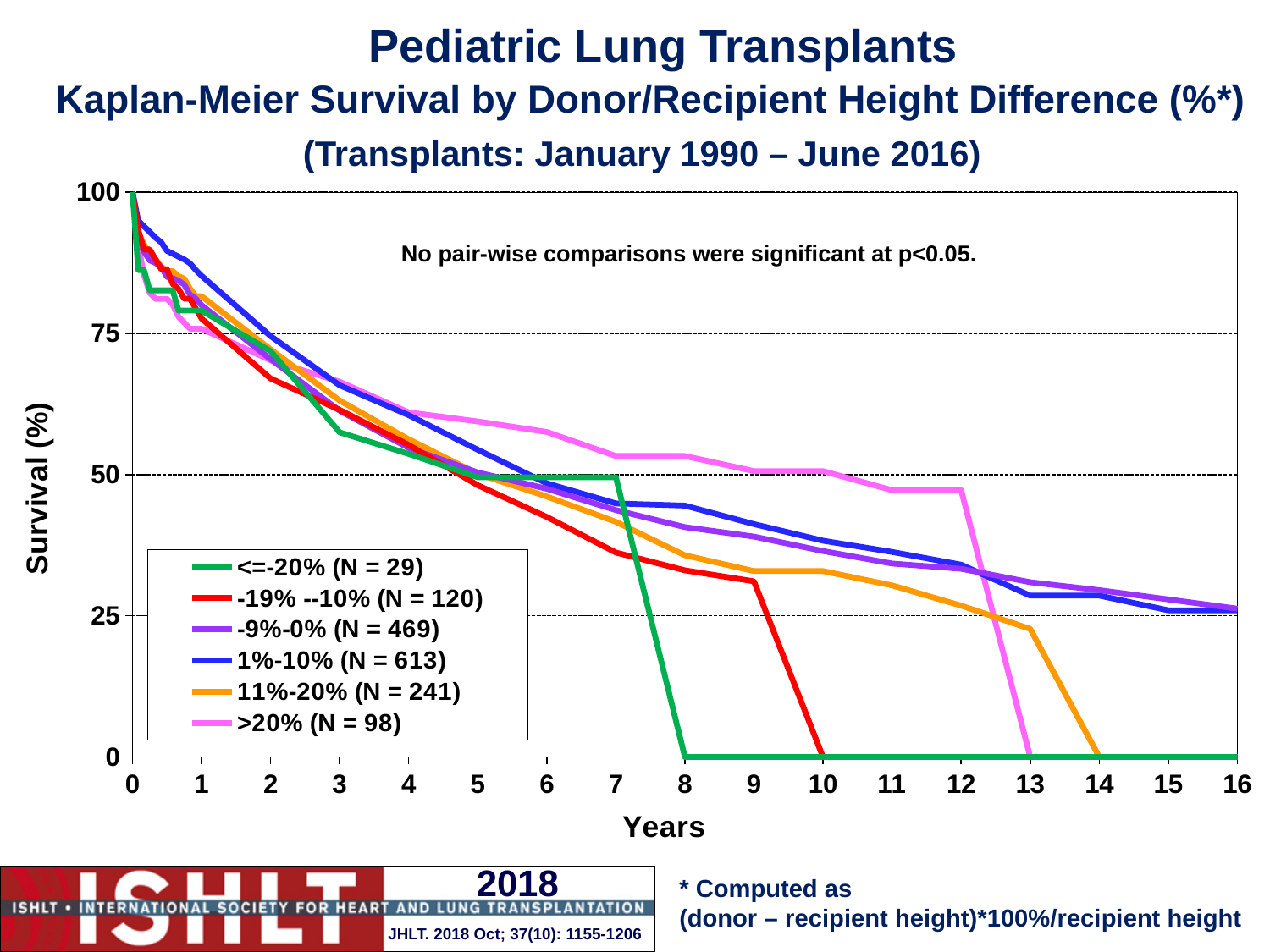
What kind of chart is shown on the slide? line chart At what year does the <=-20% survival curve drop to 0? 8 Is the survival value for the -19% --10% group at year 8 greater or less than 25? greater Do the survival curves rise or fall as years increase? fall At what year does the -19% --10% survival curve drop to 0? 10 Is the survival value for the <=-20% group at year 3 greater or less than 50? greater Which height-difference group has the smallest N in the legend? <=-20% (N = 29) What is the N for the <=-20% group shown in the legend? 29 At year 10, which group has higher survival: >20% or -9%-0%? >20% Which height-difference group has the largest N in the legend? 1%-10% (N = 613) How many series does the legend list? 6 At what year does the >20% survival curve drop to 0? 13